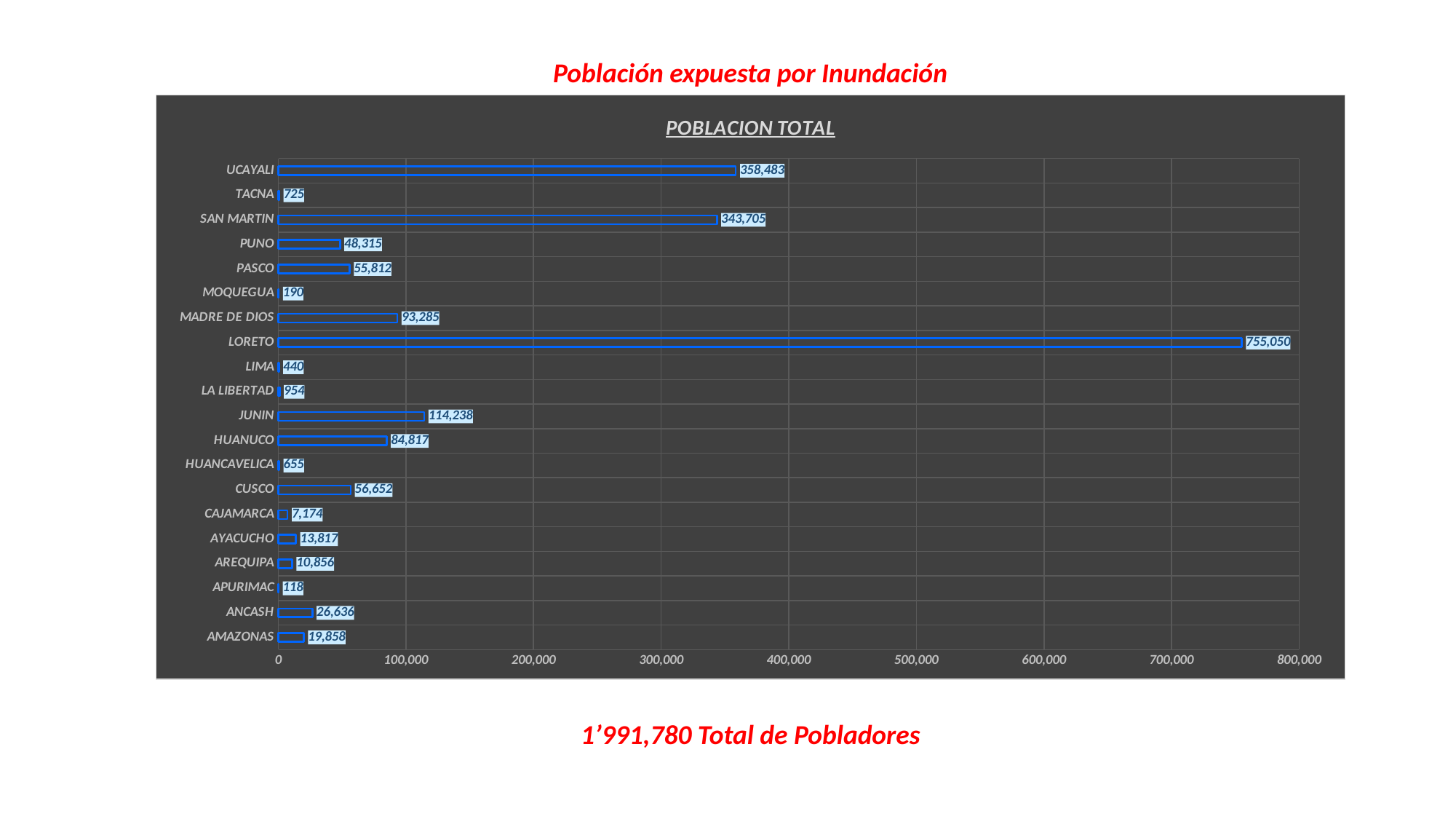
What is the value for CAJAMARCA? 7,174 Which is larger, the value for PASCO or the value for CUSCO? CUSCO What is the title of the chart? POBLACION TOTAL What is the value for MADRE DE DIOS? 93,285 Which category has the highest value? LORETO What kind of chart is shown on the slide? Bar chart Which category has the lowest value? APURIMAC How many categories are shown in the chart? 20 What is the difference between the values for JUNIN and HUANUCO? 29,421 What is the difference between the values for UCAYALI and SAN MARTIN? 14,778 Is the value for SAN MARTIN greater or less than 300,000? greater What is the value for LORETO? 755,050